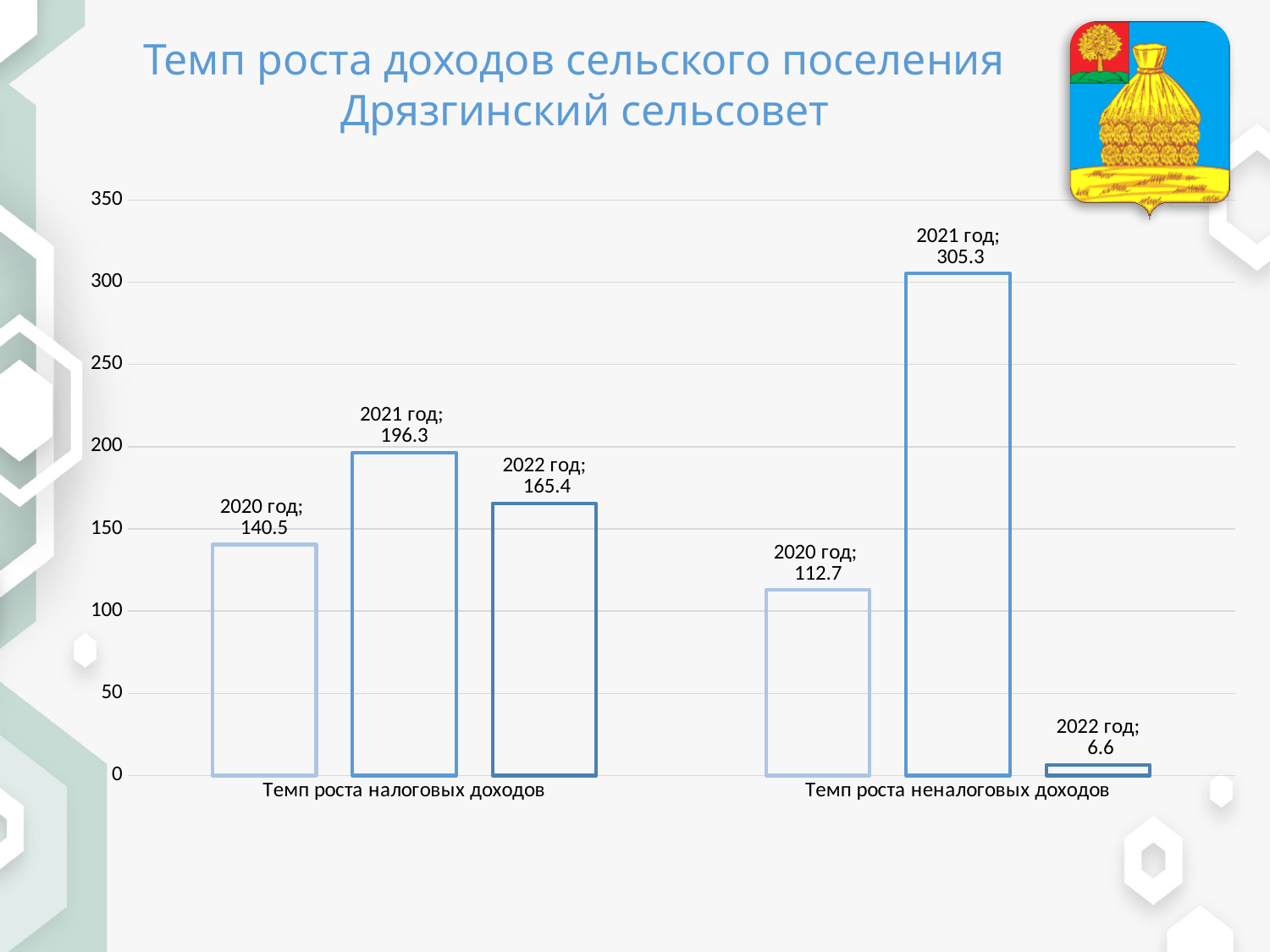
How many categories are shown on the x axis of the chart? 2 Which is larger: the 2020 год value for Темп роста налоговых доходов or the 2020 год value for Темп роста неналоговых доходов? Темп роста налоговых доходов What is the value for 2022 год in the Темп роста неналоговых доходов category? 6.6 Which year has the lowest value in the Темп роста налоговых доходов category? 2020 год What is the difference between the 2021 год and 2022 год values in the Темп роста налоговых доходов category? 30.9 What is the difference between the 2021 год values for Темп роста неналоговых доходов and Темп роста налоговых доходов? 109.0 What is the value for 2021 год in the Темп роста налоговых доходов category? 196.3 What is the title of the chart on the slide? Темп роста доходов сельского поселения Дрязгинский сельсовет Which year has the highest value in the Темп роста неналоговых доходов category? 2021 год What kind of chart is shown on the slide? bar chart What is the value for 2020 год in the Темп роста неналоговых доходов category? 112.7 Is the 2021 год value for Темп роста неналоговых доходов greater or less than 300? greater